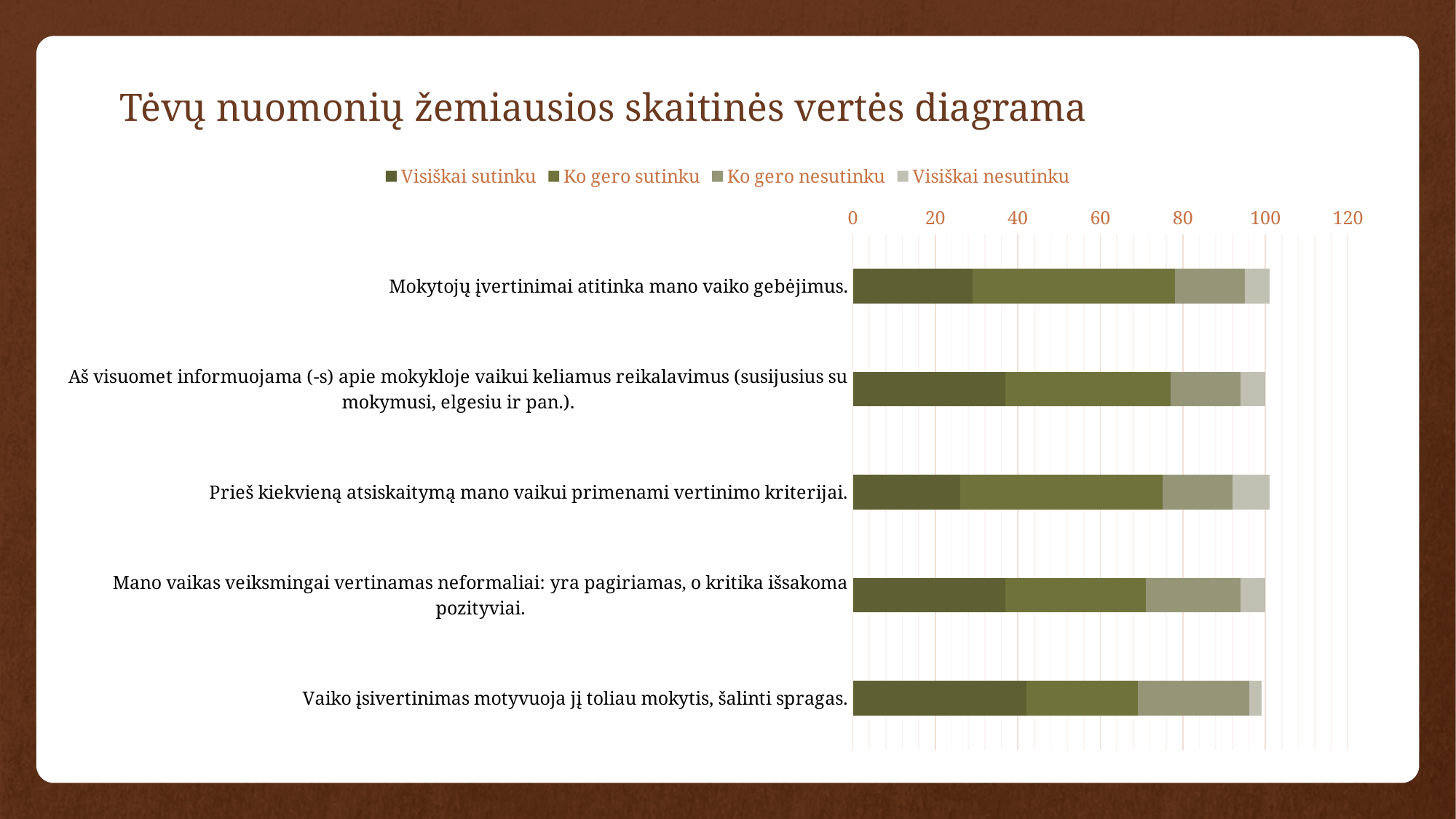
What is the highest value shown on the chart's horizontal axis? 120 What kind of chart is shown on the slide? Stacked bar chart What is the title of the chart on the slide? Tėvų nuomonių žemiausios skaitinės vertės diagrama Is the 'Visiškai sutinku' value for 'Mokytojų įvertinimai atitinka mano vaiko gebėjimus.' greater or less than 40? less How many series does the legend list? 4 Is the 'Visiškai sutinku' value for 'Mokytojų įvertinimai atitinka mano vaiko gebėjimus.' greater or less than 20? greater Is the 'Visiškai sutinku' value for 'Prieš kiekvieną atsiskaitymą mano vaikui primenami vertinimo kriterijai.' greater or less than 40? less Which statement has the largest 'Visiškai sutinku' segment? Vaiko įsivertinimas motyvuoja jį toliau mokytis, šalinti spragas. How many statements (categories) are plotted in the chart? 5 Which has the larger 'Visiškai sutinku' value: 'Vaiko įsivertinimas motyvuoja jį toliau mokytis, šalinti spragas.' or 'Prieš kiekvieną atsiskaitymą mano vaikui primenami vertinimo kriterijai.'? Vaiko įsivertinimas motyvuoja jį toliau mokytis, šalinti spragas. Which legend entry is listed first in the chart's legend? Visiškai sutinku